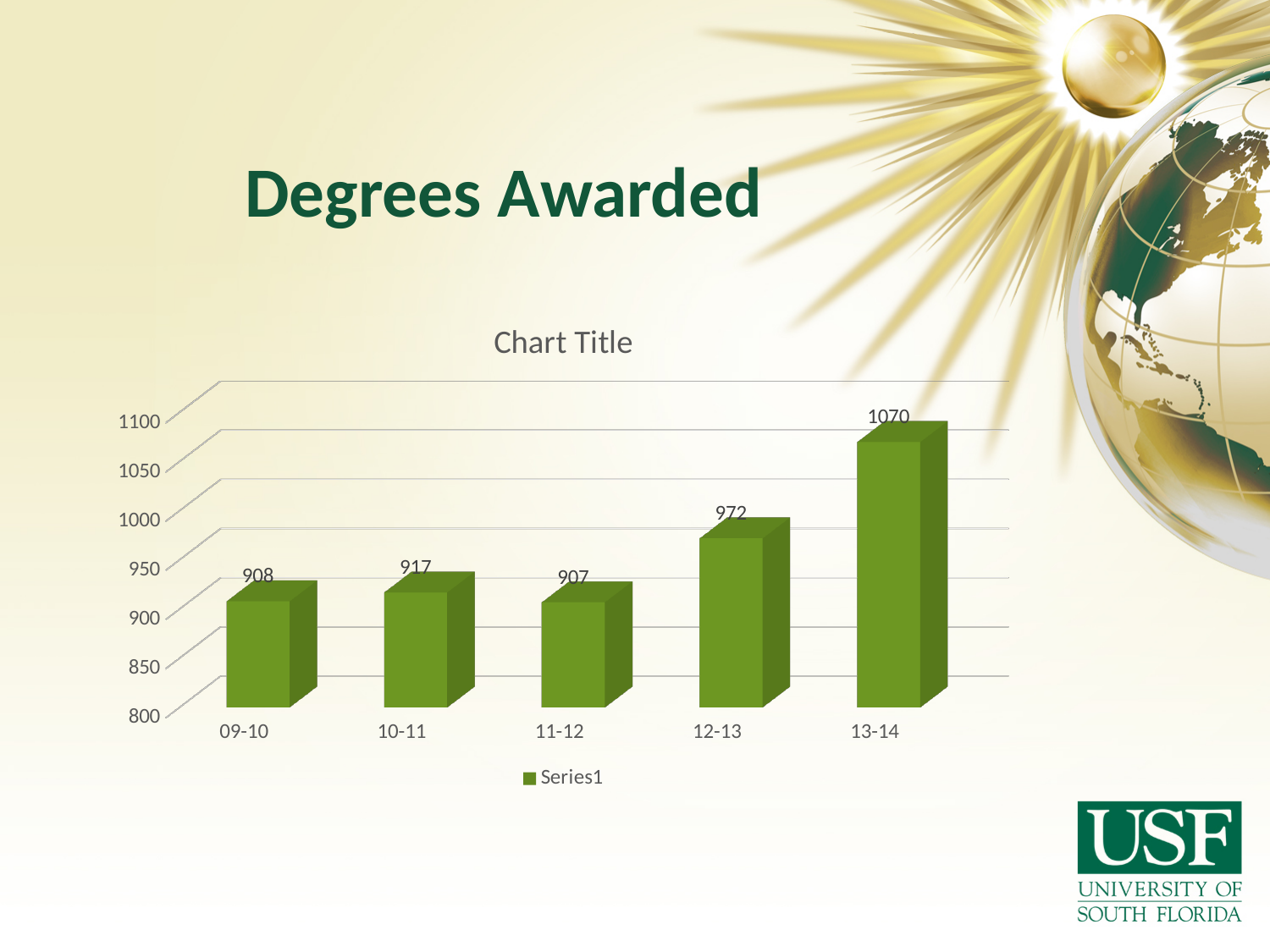
What value is shown for 09-10? 908 What is the difference between the values for 13-14 and 12-13? 98 Is the value for 12-13 greater or less than 950? greater How many years are shown on the x axis? 5 What is the name of the series listed in the legend? Series1 What is the difference between the values for 10-11 and 09-10? 9 What value is shown for 13-14? 1070 What value is shown for 11-12? 907 Which year has the highest value? 13-14 Which year has the lowest value? 11-12 What kind of chart is shown on the slide? bar chart Which is larger, the value for 12-13 or the value for 10-11? 12-13